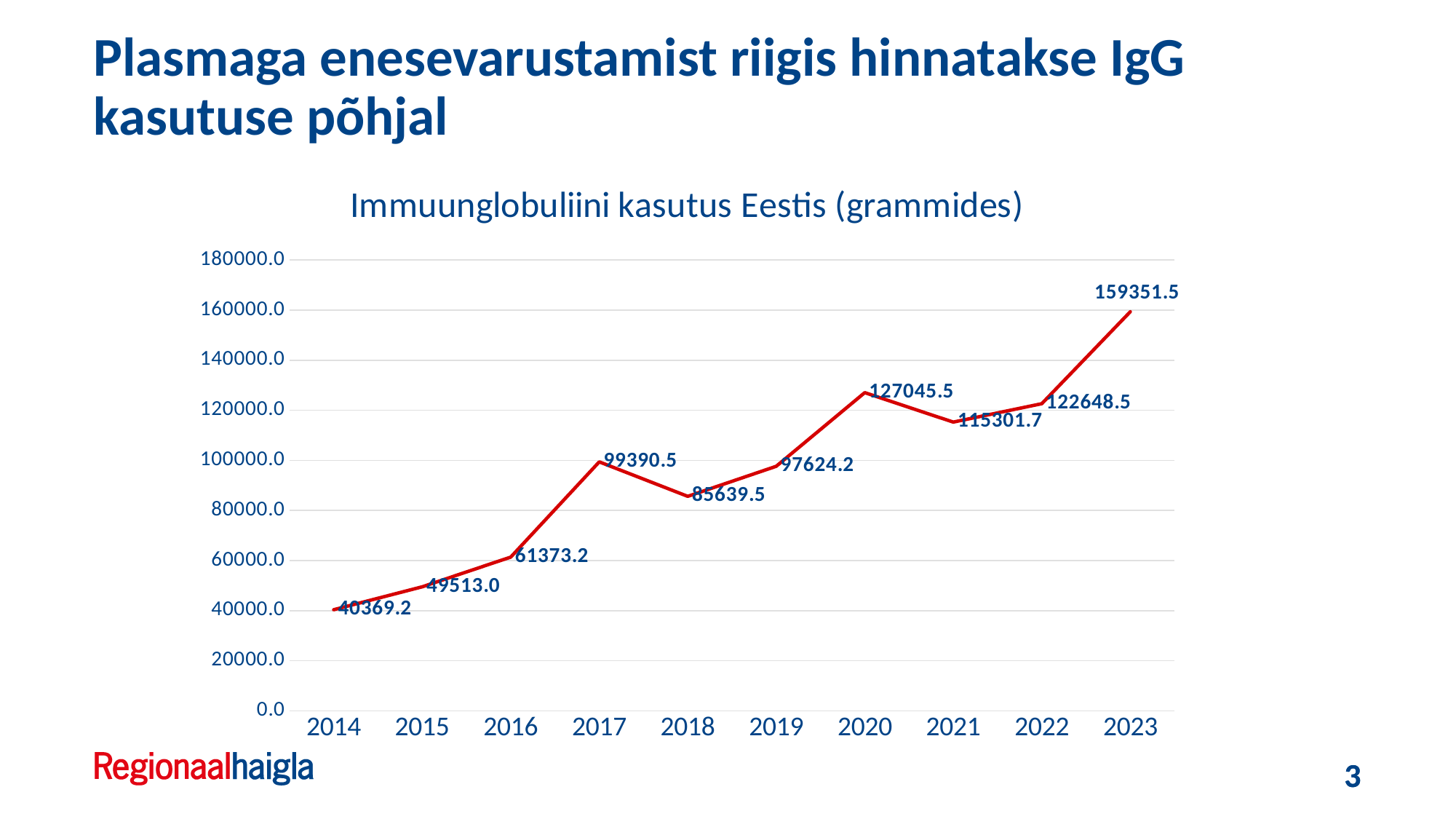
What is the difference between the values for 2023 and 2022? 36703.0 What is the value for 2014? 40369.2 Does the value rise or fall from 2020 to 2021? fall Is the value for 2020 greater or less than 120000.0? greater What type of chart is shown on the slide? line chart What is the title of the chart? Immuunglobuliini kasutus Eestis (grammides) Which year has the lowest value? 2014 Which is larger, the value for 2017 or the value for 2018? 2017 How many years are plotted on the x axis? 10 Which year has the highest value? 2023 What is the value for 2021? 115301.7 What is the value for 2017? 99390.5